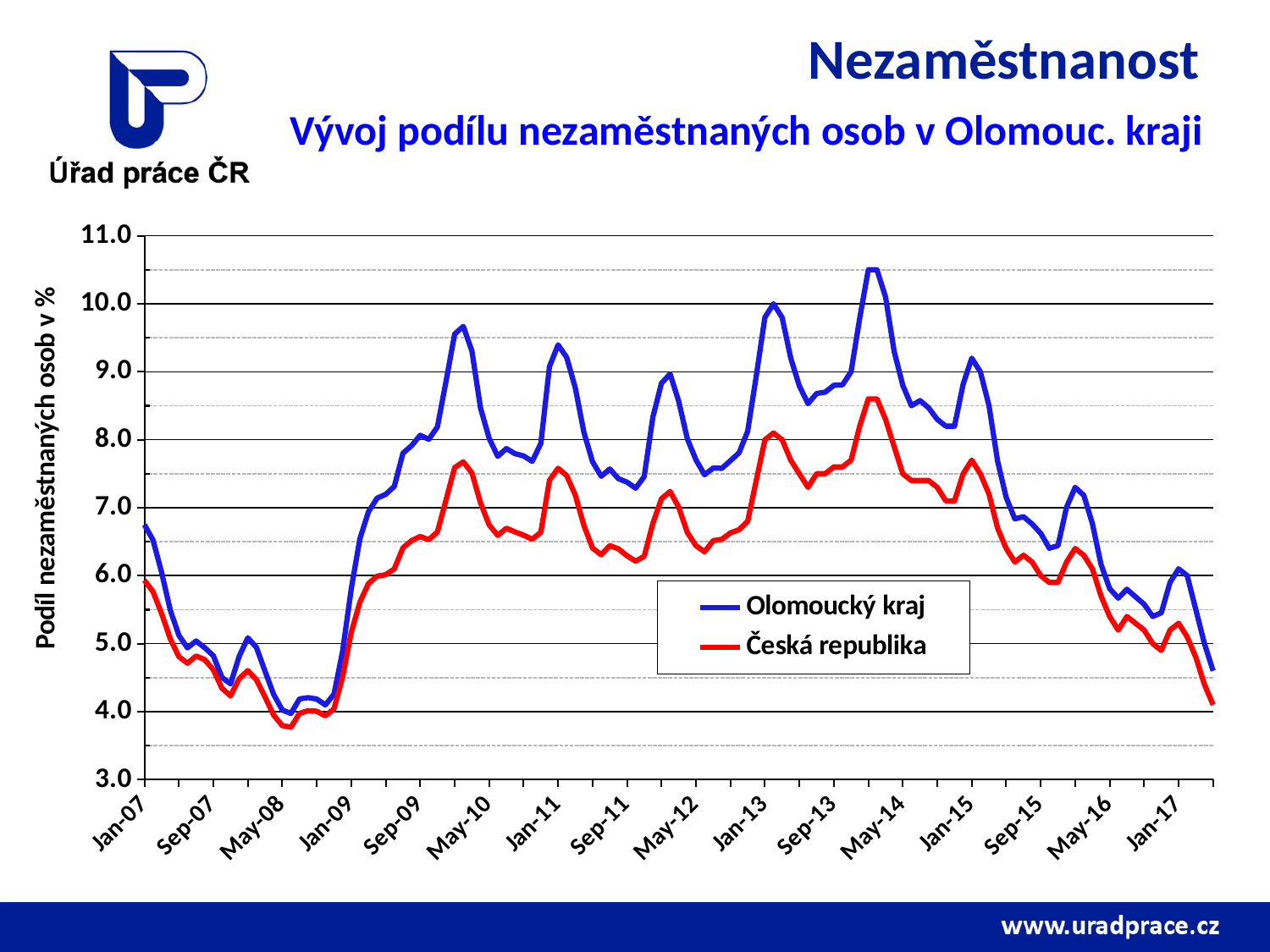
Is the highest value reached by Olomoucký kraj greater or less than 10.0? greater Is the value for Olomoucký kraj at Jan-07 greater or less than 6.0? greater Which series reaches the highest value on the chart? Olomoucký kraj What is the label of the y axis? Podíl nezaměstnaných osob v % How many series does the legend list? 2 What kind of chart is shown on the slide? line chart How many date labels are shown on the x axis? 16 Is the highest value reached by Česká republika greater or less than 9.0? less What is the title of the chart? Vývoj podílu nezaměstnaných osob v Olomouc. kraji Does the value for Olomoucký kraj rise or fall between Jan-09 and Sep-09? rise At Jan-13, which series has the larger value, Olomoucký kraj or Česká republika? Olomoucký kraj